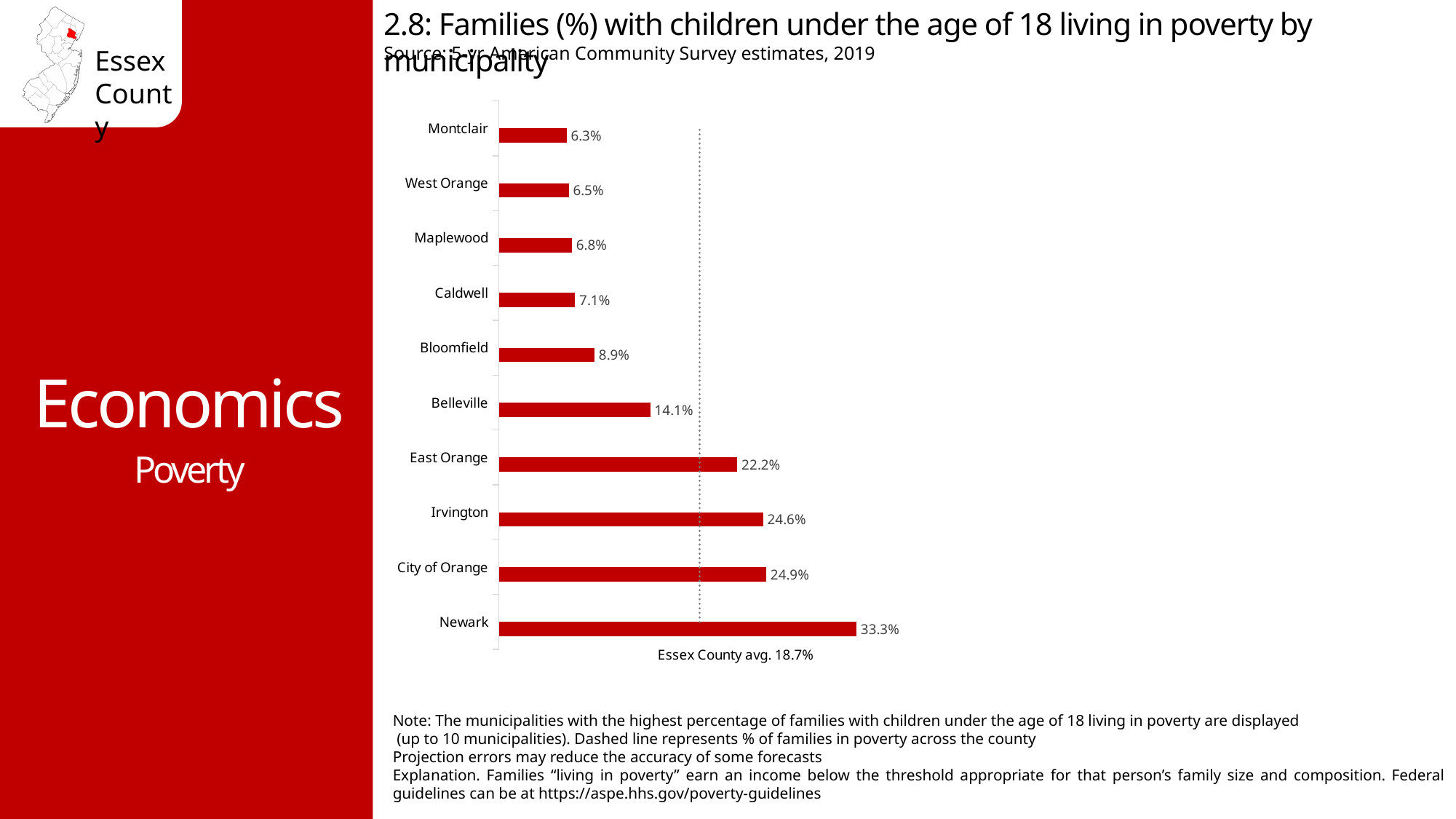
What Essex County average is indicated by the dotted line on the chart? 18.7% What kind of chart is shown on the slide? Bar chart How many municipalities are shown on the chart? 10 What is the difference between the values for East Orange and Bloomfield? 13.3% Which municipality has the highest percentage of families with children living in poverty? Newark What is the value shown for Caldwell? 7.1% What percentage of families with children under 18 live in poverty in Newark? 33.3% What is the value shown for Belleville? 14.1% What is the value shown for Maplewood? 6.8% Which municipality has the lowest percentage shown on the chart? Montclair Which has a higher value, Irvington or East Orange? Irvington What is the difference between the values for Newark and City of Orange? 8.4%